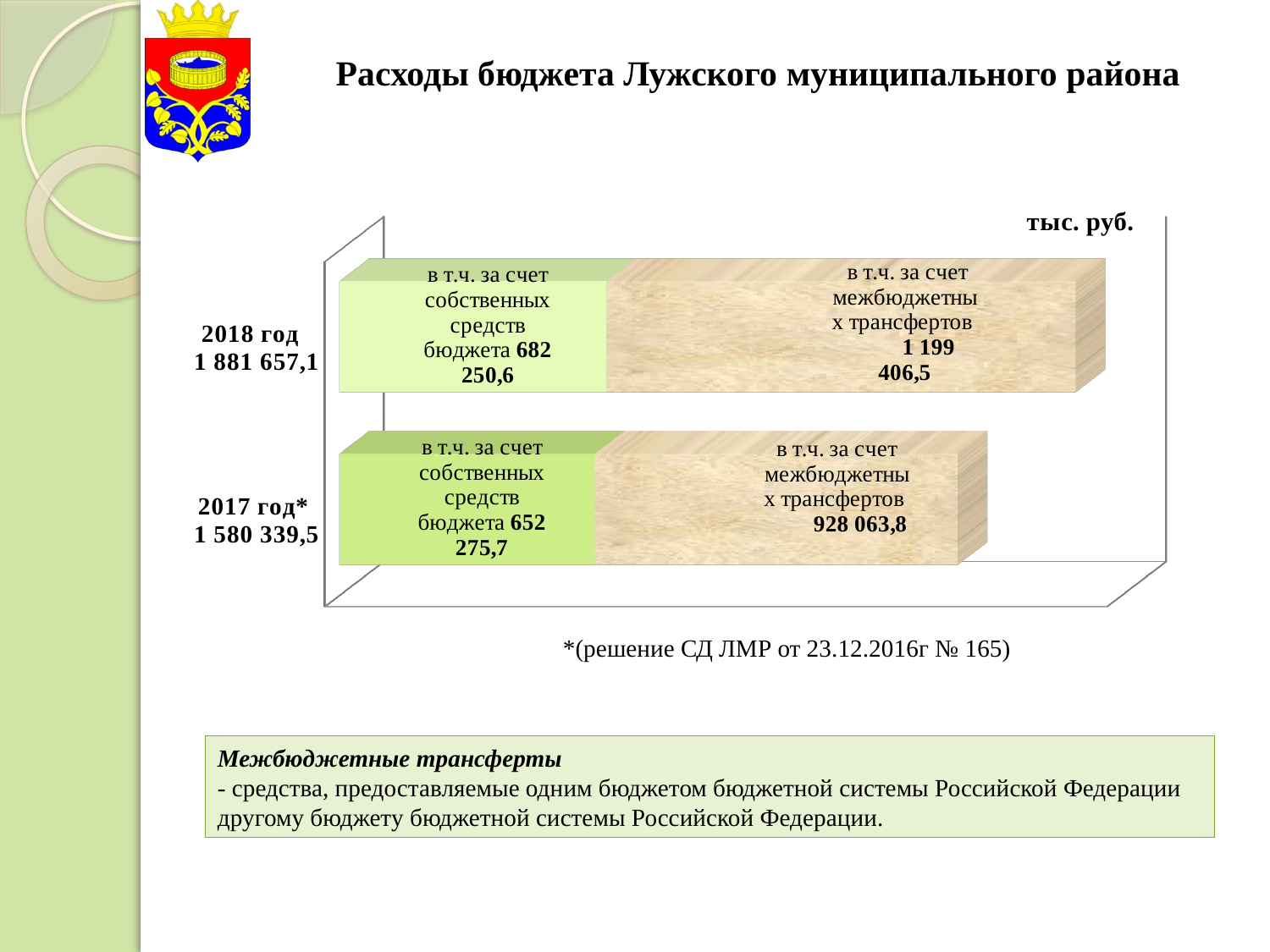
In what units are the values in the chart given? тыс. руб. By how much did expenditure from intergovernmental transfers increase from 2017 to 2018? 271 342,7 How many years (categories) are plotted in the chart? 2 What kind of chart is shown on the slide? bar chart What is the difference between the total expenditures of 2018 and 2017? 301 317,6 Which year has the higher total budget expenditure? 2018 год In 2018, which is larger: expenditure from own budget funds or from intergovernmental transfers? intergovernmental transfers (межбюджетные трансферты) What is the value of expenditure from own budget funds (за счет собственных средств бюджета) in 2018? 682 250,6 What is the total budget expenditure shown for 2018 год? 1 881 657,1 What is the total budget expenditure shown for 2017 год*? 1 580 339,5 What is the value of expenditure from intergovernmental transfers (за счет межбюджетных трансфертов) in 2017? 928 063,8 What is the value of expenditure from intergovernmental transfers in 2018? 1 199 406,5